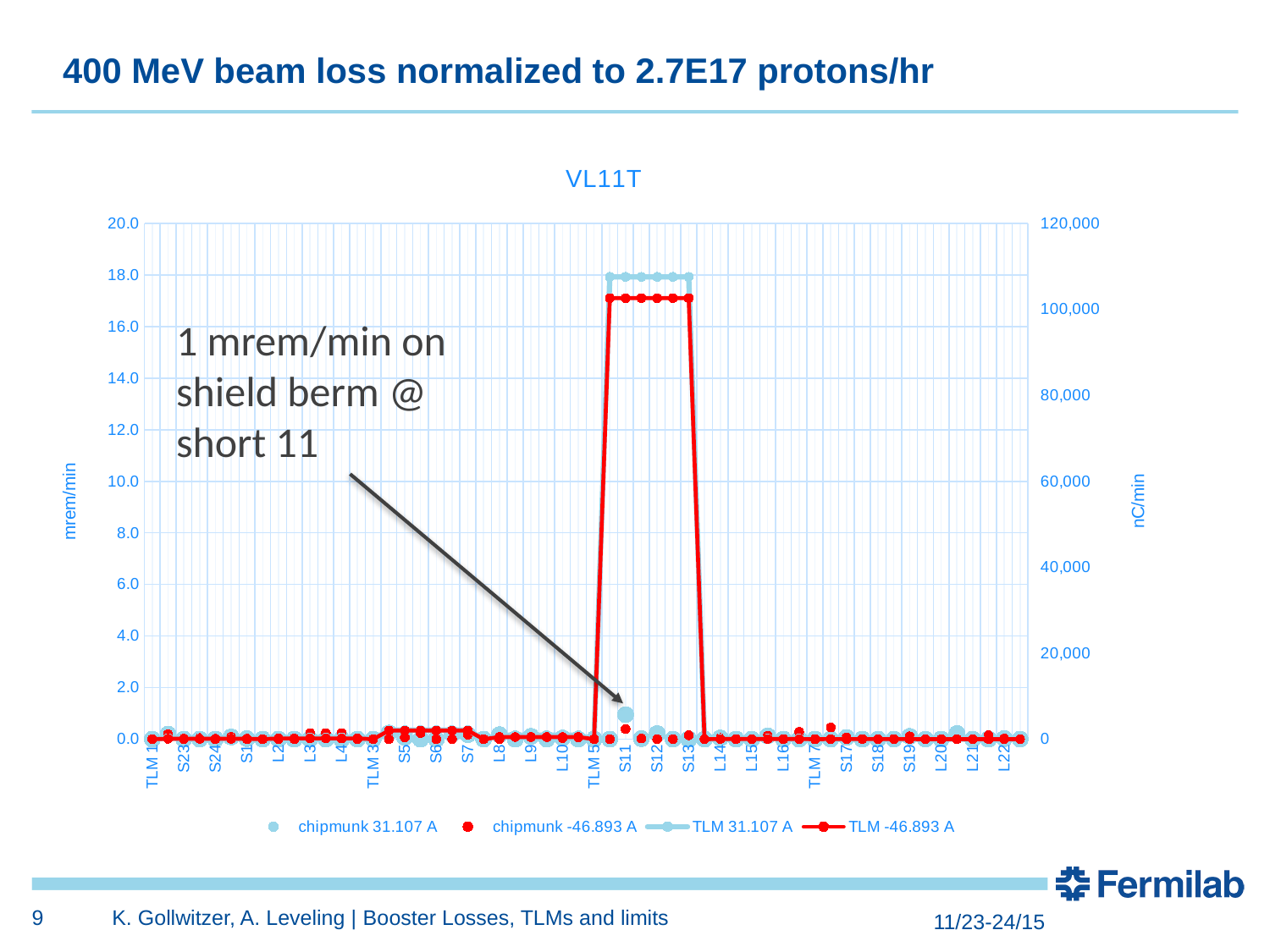
Is the value of TLM -46.893 A at S12 greater or less than 80,000 nC/min? greater How many series does the legend of the VL11T chart list? 4 What is the label of the right-hand vertical axis? nC/min What is the title of the chart? VL11T Is the value of TLM 31.107 A at S12 greater or less than 100,000 nC/min? greater Is the chipmunk 31.107 A value at S11 greater or less than 2.0 mrem/min? less At S11, which series has the larger value, TLM 31.107 A or TLM -46.893 A? TLM 31.107 A What is the highest tick value shown on the left vertical axis (mrem/min)? 20.0 What kind of chart is shown on the slide? line chart